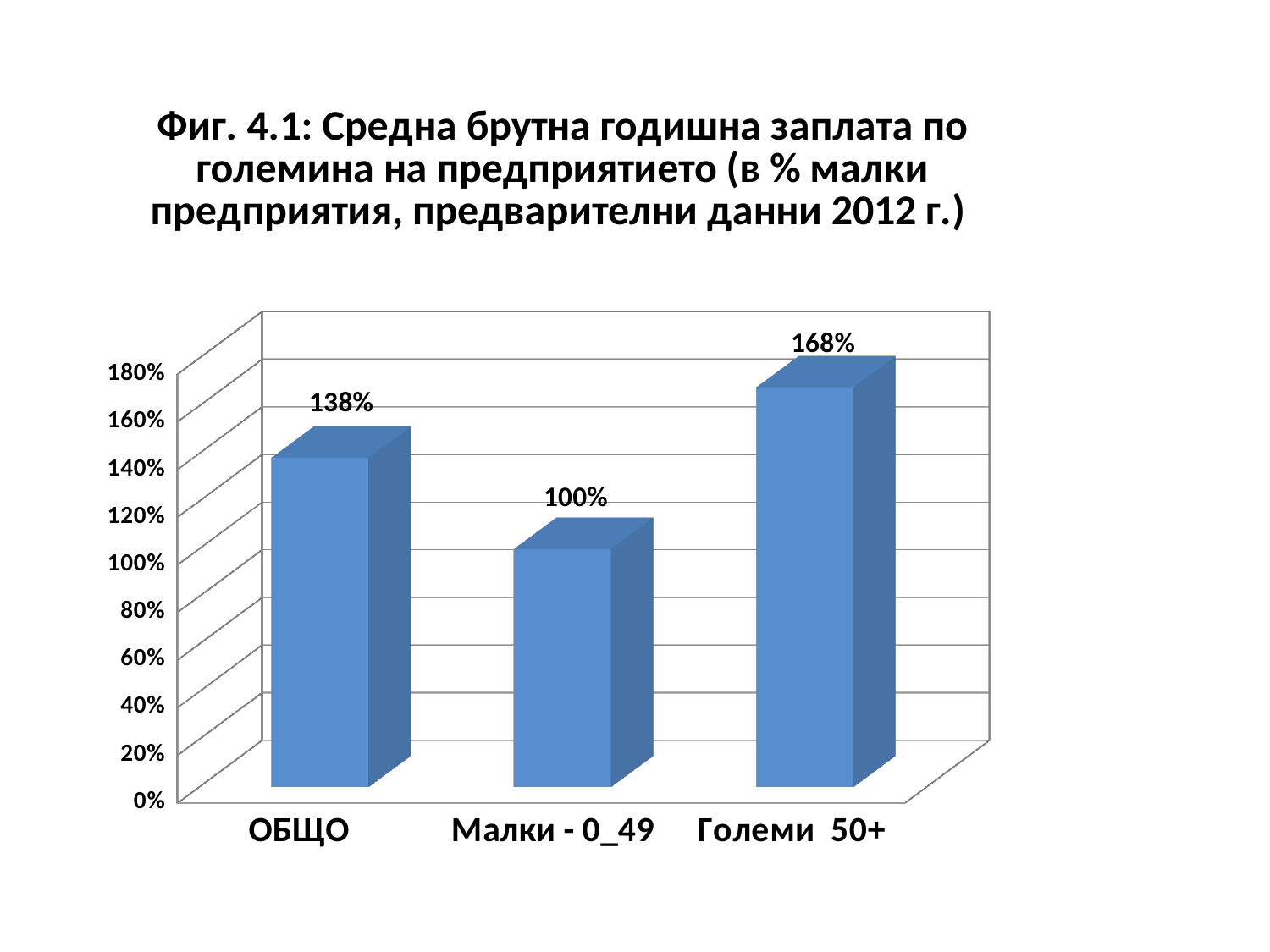
What is the value for Големи 50+? 168% What is the difference between the values for Големи 50+ and Малки - 0_49? 68% Which is larger, the value for ОБЩО or the value for Големи 50+? Големи 50+ What is the value for Малки - 0_49? 100% What is the difference between the values for ОБЩО and Малки - 0_49? 38% How many categories are shown on the x axis? 3 Which category has the lowest value? Малки - 0_49 What is the figure number given in the chart title? Фиг. 4.1 What kind of chart is shown on the slide? bar chart Is the value for ОБЩО greater or less than 120%? greater What is the value for ОБЩО? 138% Which category has the highest value? Големи 50+